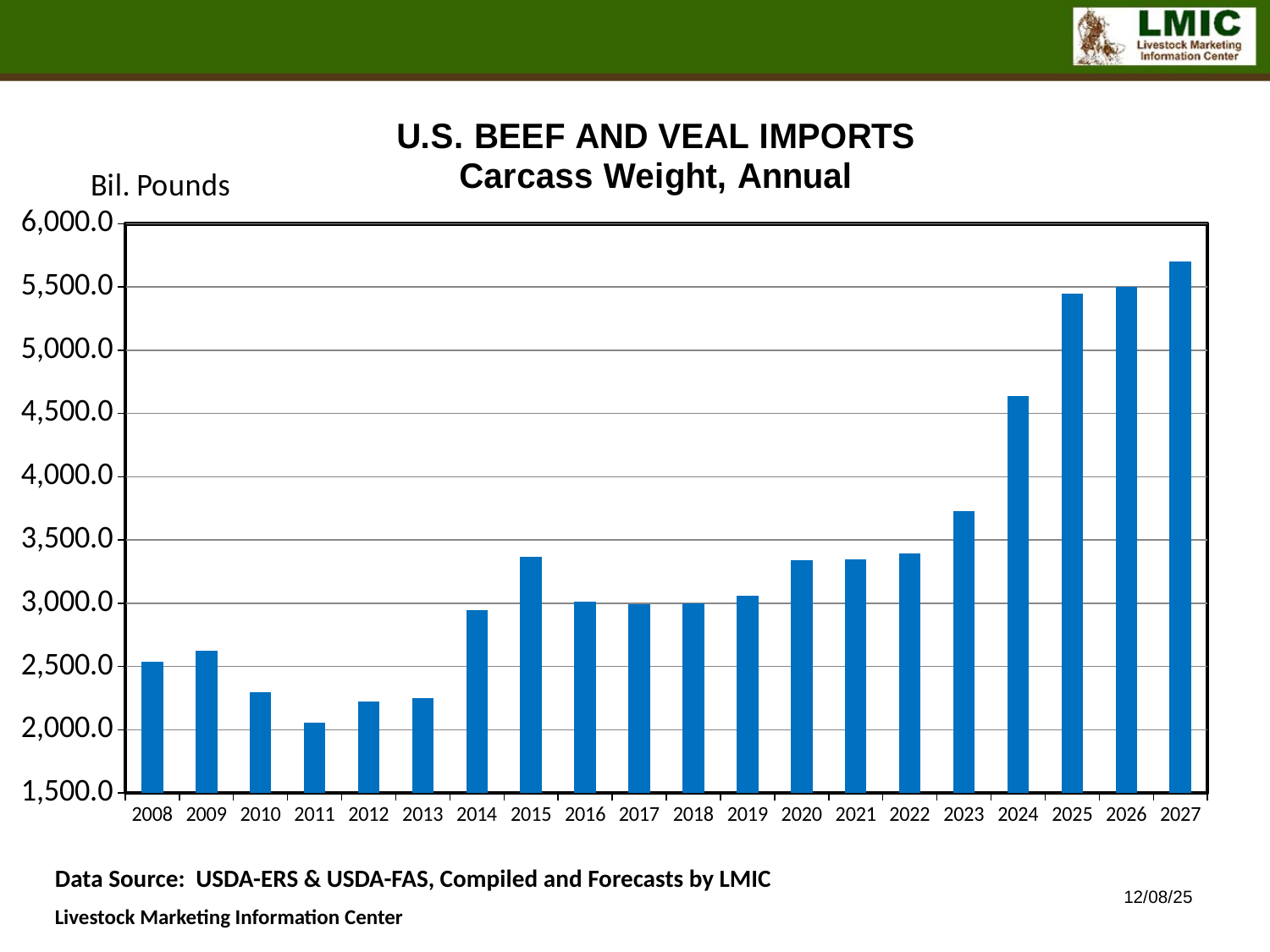
Is the value for 2010 greater or less than 2,500.0? less Do the values generally rise or fall from 2019 to 2027? rise What kind of chart is shown on the slide? bar chart Is the value for 2027 greater or less than 5,500.0? greater How many years are plotted on the x axis? 20 Which year has the lowest value for U.S. beef and veal imports? 2011 Which year has the highest value for U.S. beef and veal imports? 2027 Is the value for 2024 greater or less than 4,500.0? greater What unit is shown on the y axis label of the chart? Bil. Pounds Which is larger, the value for 2023 or the value for 2024? 2024